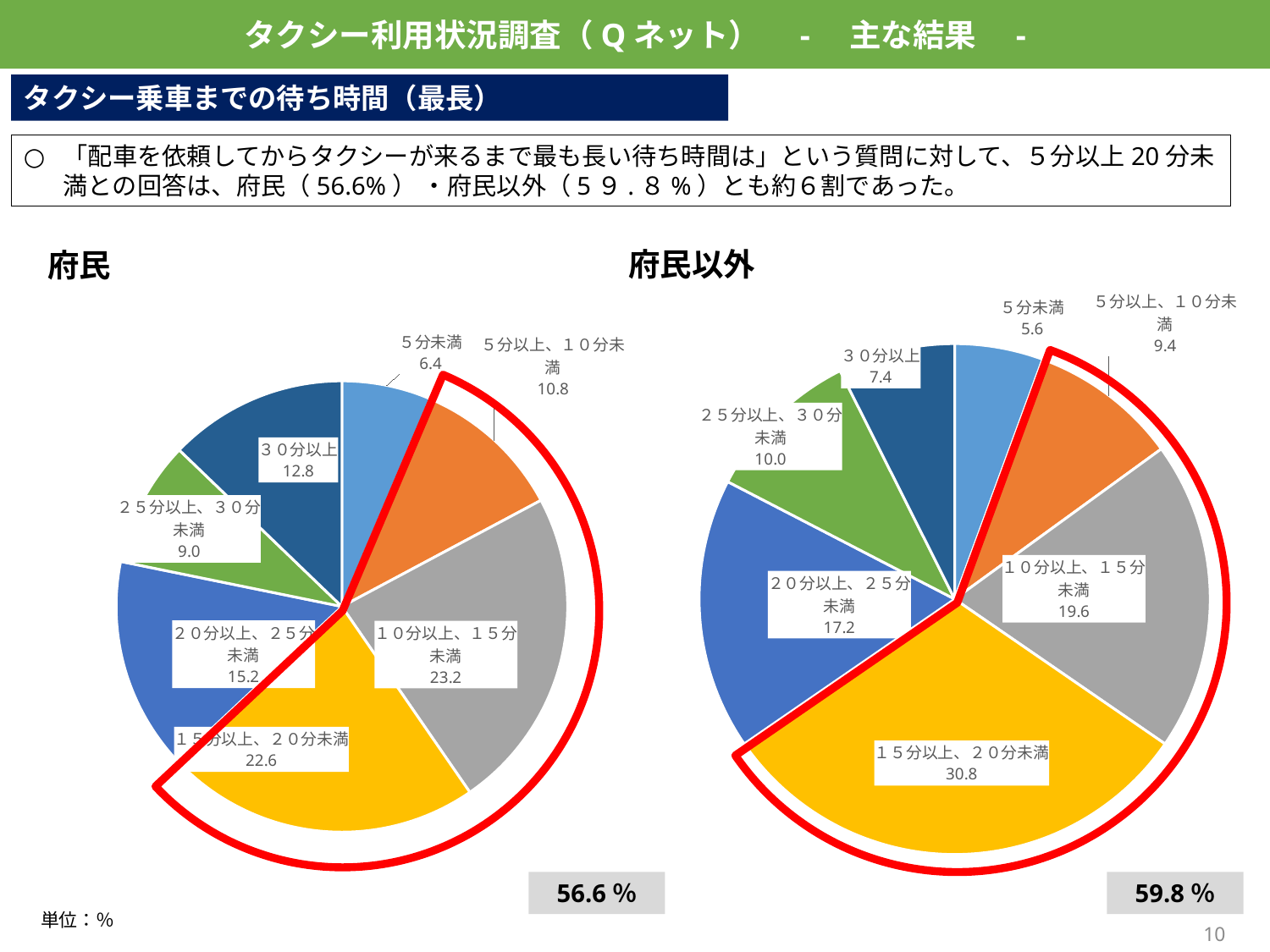
In the 府民以外 pie chart, what is the difference between 15分以上、20分未満 and 10分以上、15分未満? 11.2 In the 府民 pie chart, what is the value for 10分以上、15分未満? 23.2 In the 府民以外 pie chart, what is the value for 25分以上、30分未満? 10.0 In the 府民以外 pie chart, what is the value for 15分以上、20分未満? 30.8 How many categories does the 府民 pie chart show? 7 In the 府民 pie chart, what is the combined share of 5分以上、10分未満, 10分以上、15分未満 and 15分以上、20分未満? 56.6 In the 府民 pie chart, what is the value for 5分未満? 6.4 What type of chart is used for 府民以外? Pie chart In the 府民 pie chart, which is larger: 20分以上、25分未満 or 30分以上? 20分以上、25分未満 In the 府民以外 pie chart, which category has the smallest share? 5分未満 What unit is indicated for the values in the charts? % In the 府民 pie chart, which category has the largest share? 10分以上、15分未満